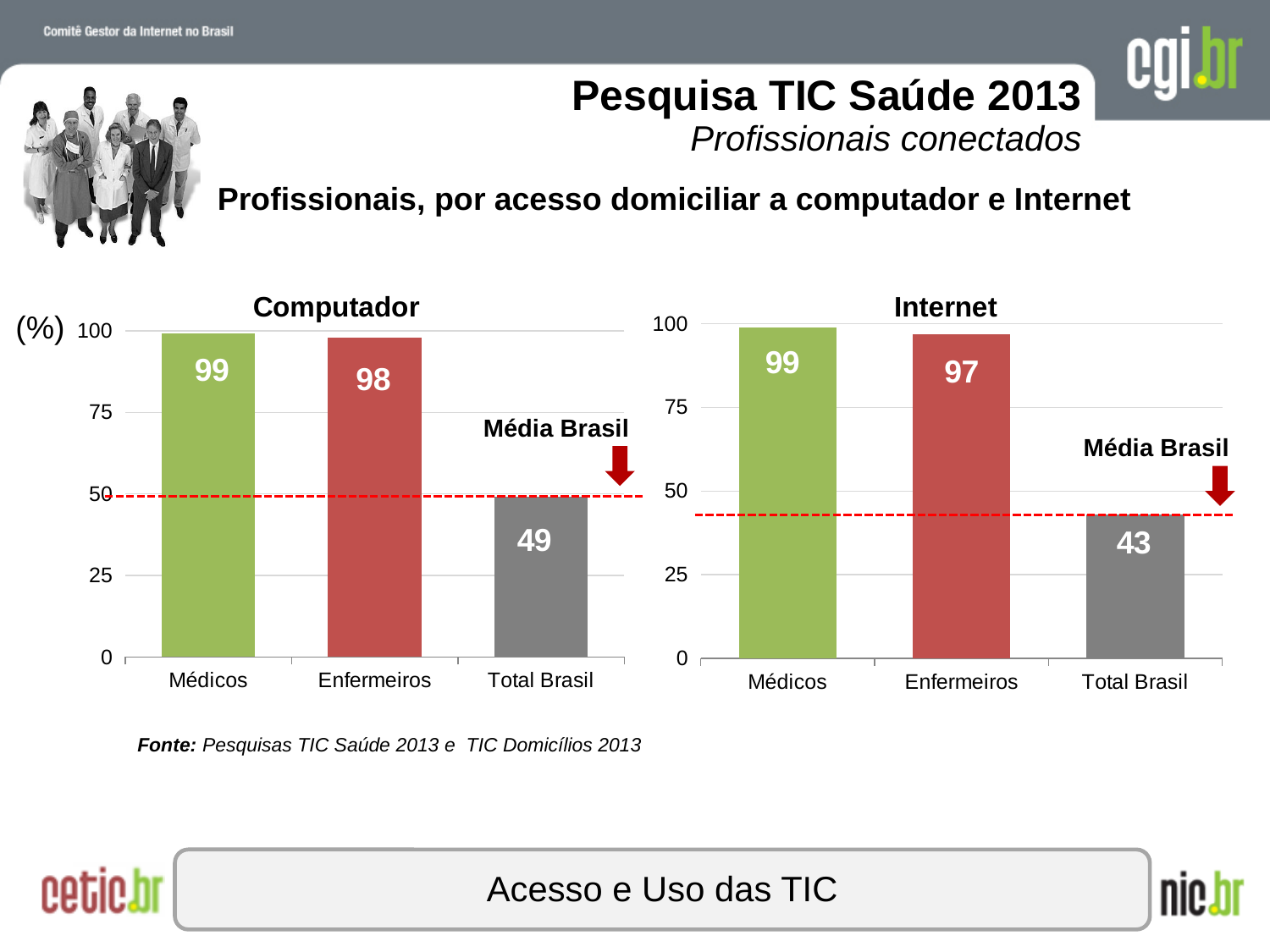
What kind of chart is the Internet chart? bar chart In the Computador chart, which category has the highest value? Médicos In the Internet chart, is the value for Total Brasil greater or less than 50? less In the Internet chart, which category has the lowest value? Total Brasil In the Internet chart, what is the value for Enfermeiros? 97 In the Computador chart, what is the difference between the values for Enfermeiros and Total Brasil? 49 In the Internet chart, what is the value for Total Brasil? 43 In the Internet chart, what is the difference between the values for Médicos and Total Brasil? 56 What does the red dashed line in each chart represent? Média Brasil How many categories are shown in the Computador chart? 3 In the Computador chart, what is the value for Total Brasil? 49 In the Computador chart, what is the value for Médicos? 99